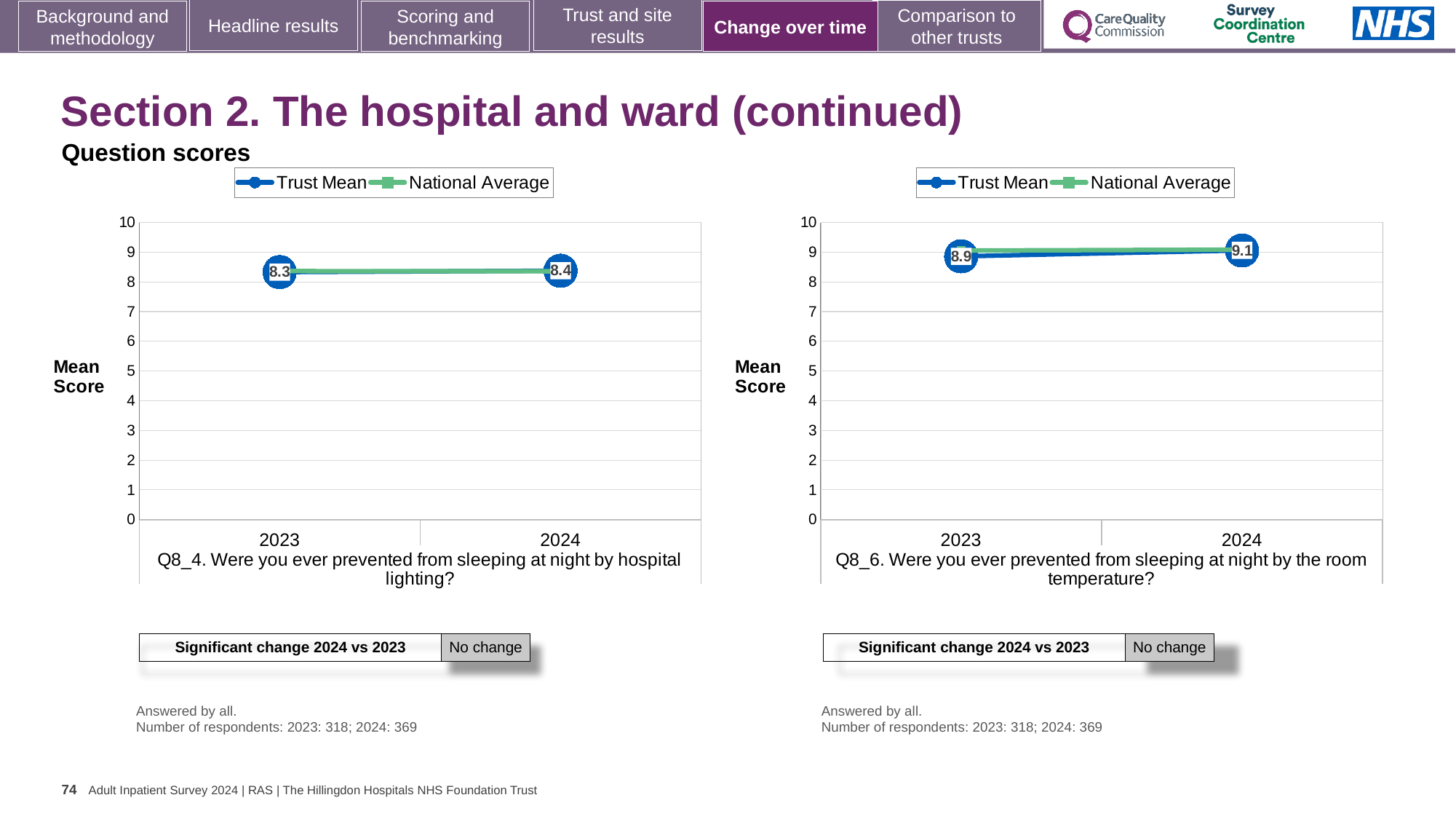
How many series does the legend of the right chart (Q8_6, room temperature) list? 2 In the left chart (Q8_4, hospital lighting), what is the Trust Mean score for 2023? 8.3 What kind of chart is the left chart (Q8_4, hospital lighting)? line chart In the left chart (Q8_4, hospital lighting), is the Trust Mean for 2024 greater or less than 8? greater In the left chart (Q8_4, hospital lighting), does the Trust Mean rise or fall from 2023 to 2024? rise How many years are plotted on the x axis of the right chart (Q8_6, room temperature)? 2 In the right chart (Q8_6, room temperature), what is the Trust Mean score for 2023? 8.9 In the right chart (Q8_6, room temperature), what is the Trust Mean score for 2024? 9.1 In the right chart (Q8_6, room temperature), which year has the higher Trust Mean score, 2023 or 2024? 2024 In the left chart (Q8_4, hospital lighting), what is the Trust Mean score for 2024? 8.4 In the right chart (Q8_6, room temperature), by how much did the Trust Mean change from 2023 to 2024? 0.2 In the left chart (Q8_4, hospital lighting), by how much did the Trust Mean change from 2023 to 2024? 0.1